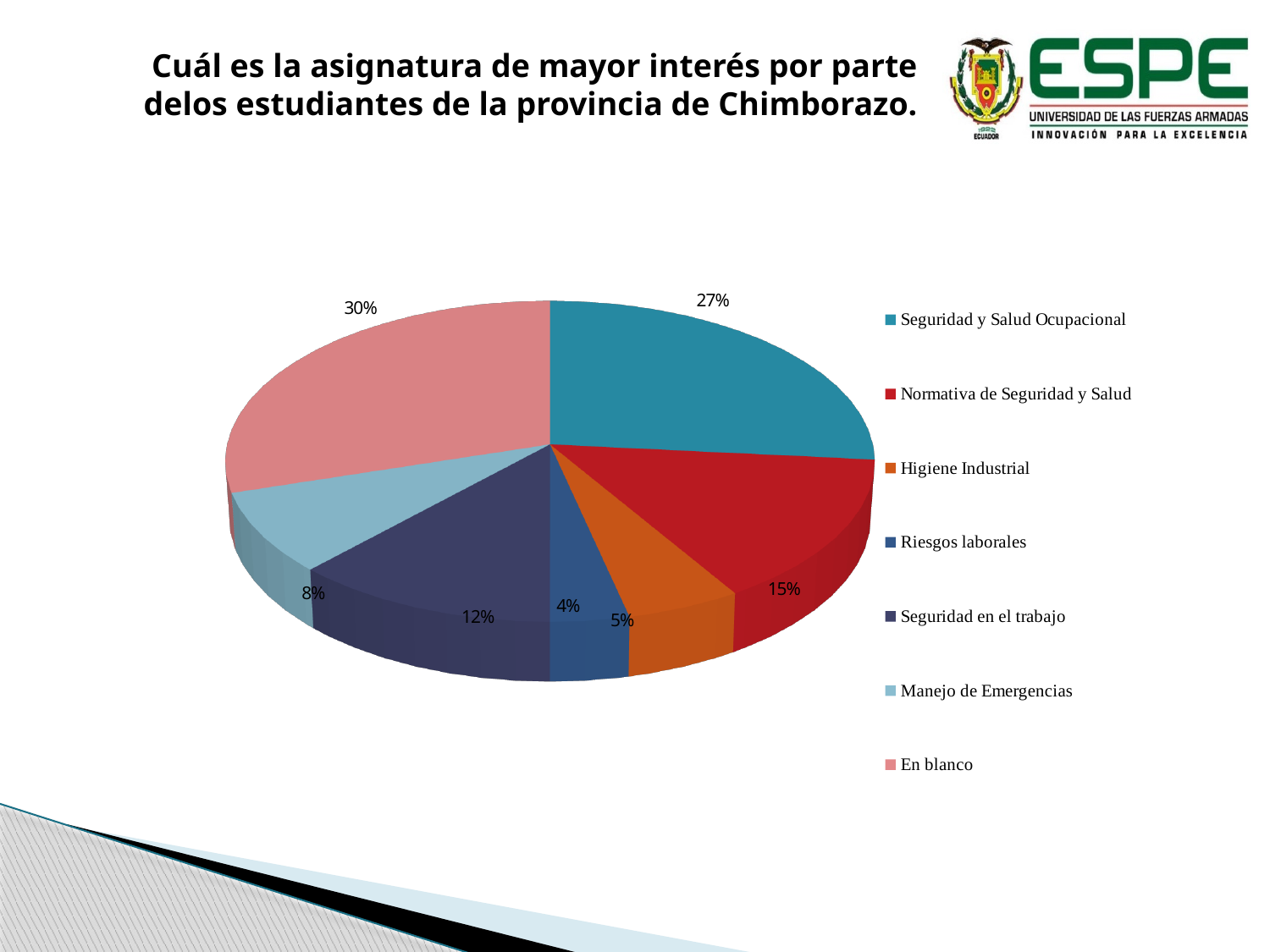
What is the value for Normativa de Seguridad y Salud? 15% Which legend entry is shown in orange? Higiene Industrial What is the difference between the shares of En blanco and Seguridad y Salud Ocupacional? 3% What share of the pie does Seguridad y Salud Ocupacional have? 27% What share of the pie does En blanco have? 30% How many categories does the pie chart have? 7 What is the value for Seguridad en el trabajo? 12% Which category has the smallest slice of the pie? Riesgos laborales What kind of chart is shown on the slide? Pie chart What is the value for Riesgos laborales? 4% Which is larger, Manejo de Emergencias or Higiene Industrial? Manejo de Emergencias Which category has the largest slice of the pie? En blanco